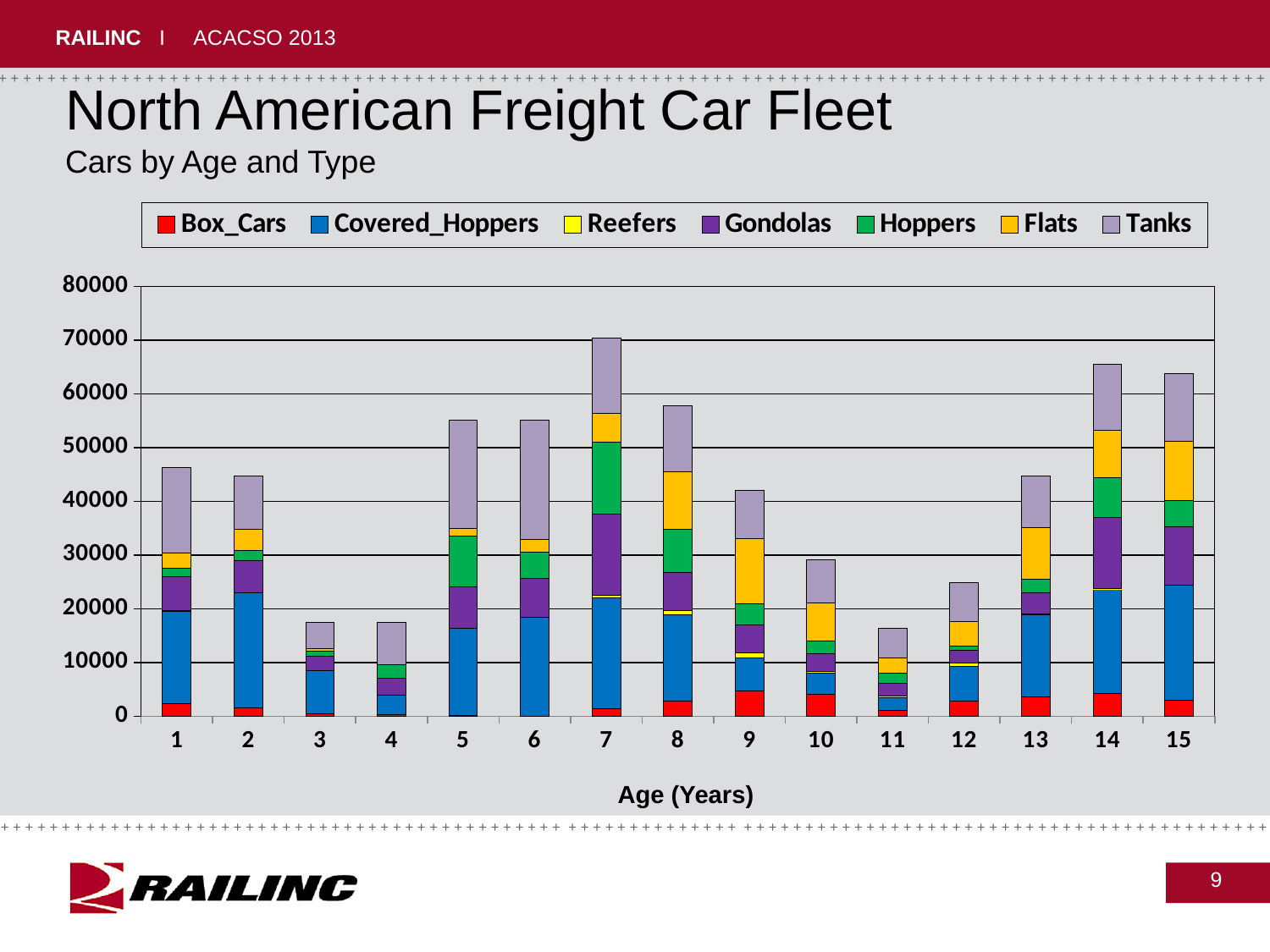
Which age has the highest total number of cars? 7 Which has a larger total, age 9 or age 10? Age 9 What is the title of the x axis? Age (Years) Is the total for age 1 greater or less than 50000? less How many age categories are shown on the x axis? 15 Which has a larger total, age 7 or age 8? Age 7 How many series does the legend list? 7 Is the total for age 11 greater or less than 20000? less Do the bar totals rise or fall from age 11 to age 14? Rise Is the total for age 7 greater or less than 60000? greater What kind of chart is shown on the slide? Stacked bar chart